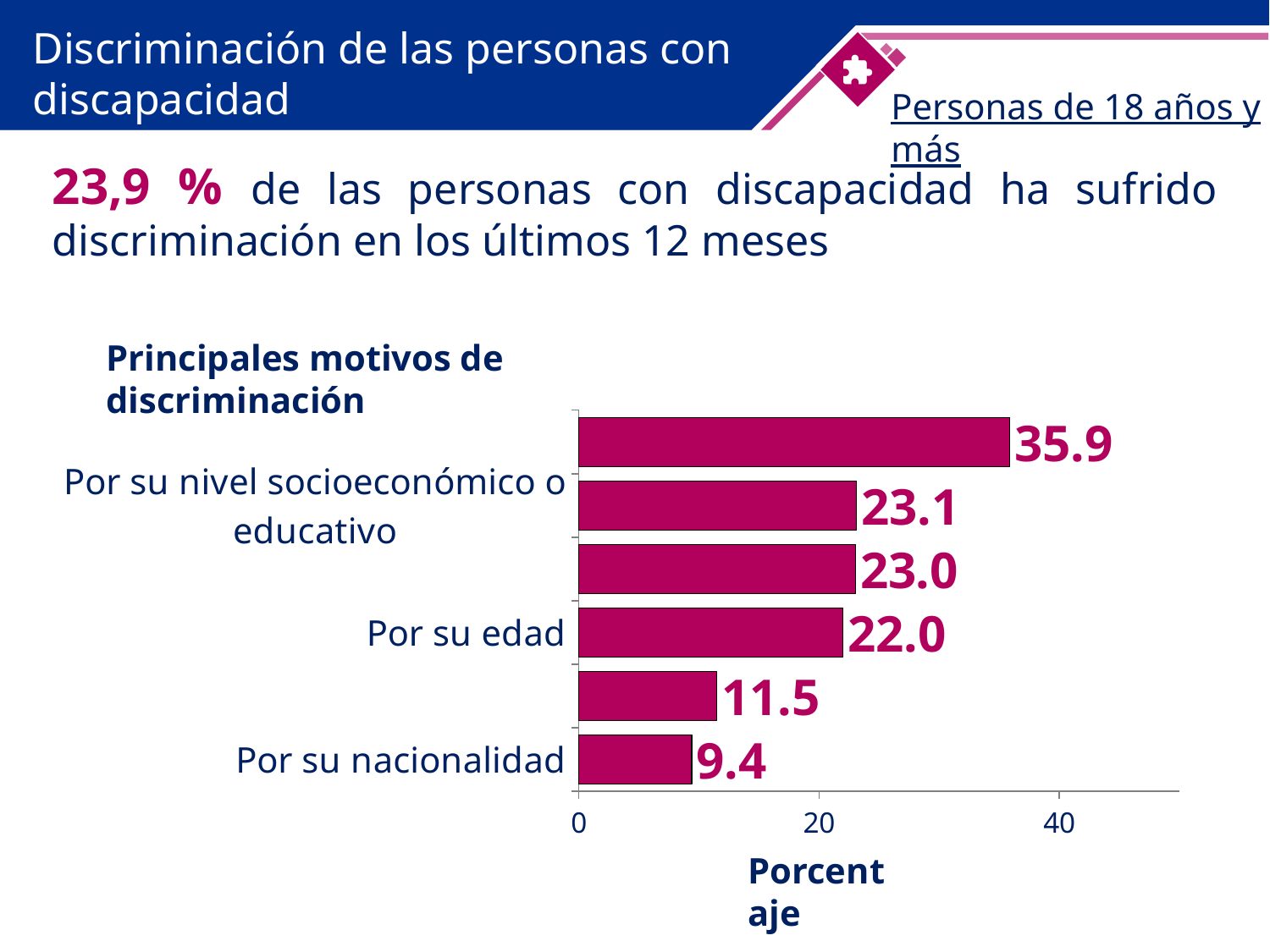
What is the highest value shown in the chart? 35.9 What is the value of the topmost bar in the chart? 35.9 What is the title of the horizontal axis of the chart? Porcentaje What kind of chart is shown on the slide? Bar chart Which category has the lowest value? Por su nacionalidad What is the difference between the highest value (35.9) and the lowest value (9.4)? 26.5 What is the value for 'Por su nacionalidad'? 9.4 Which is larger: the value for 'Por su nivel socioeconómico o educativo' or the value for 'Por su edad'? Por su nivel socioeconómico o educativo What is the value for 'Por su edad'? 22.0 How many bars are plotted in the chart? 6 What is the difference between the values for 'Por su edad' and 'Por su nacionalidad'? 12.6 What is the value for 'Por su nivel socioeconómico o educativo'? 23.1